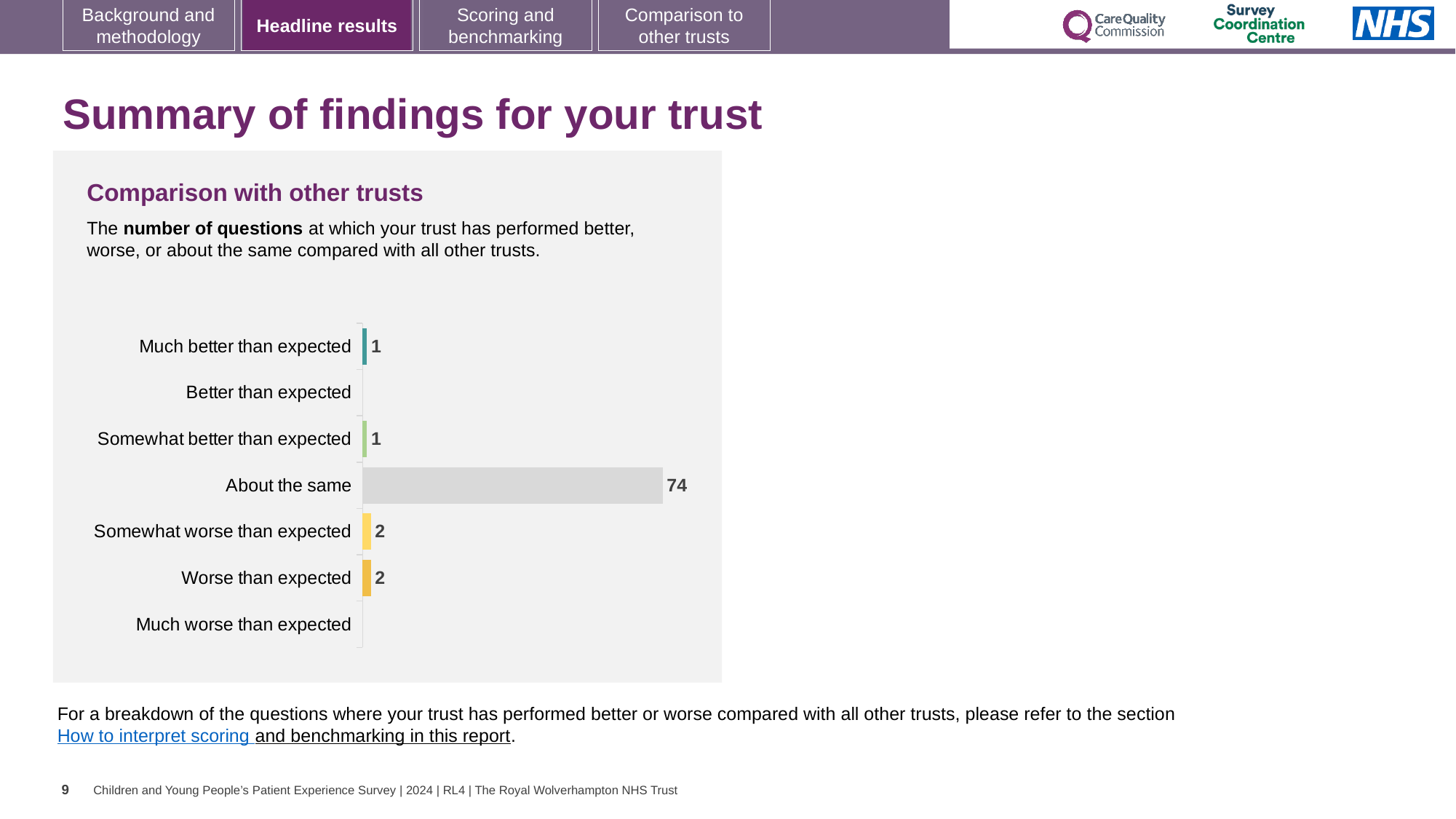
Which is larger, the value for 'Somewhat worse than expected' or the value for 'Somewhat better than expected'? Somewhat worse than expected What kind of chart is shown on the slide? Bar chart What is the value for 'About the same'? 74 What is the title of the chart section? Comparison with other trusts What is the difference between the values for 'About the same' and 'Worse than expected'? 72 What is the value for 'Worse than expected'? 2 How many categories are shown on the chart? 7 What is the total of the values for 'Much better than expected' and 'Somewhat better than expected'? 2 What is the value for 'Much better than expected'? 1 Which category has the highest value? About the same What is the value for 'Somewhat better than expected'? 1 What is the value for 'Somewhat worse than expected'? 2